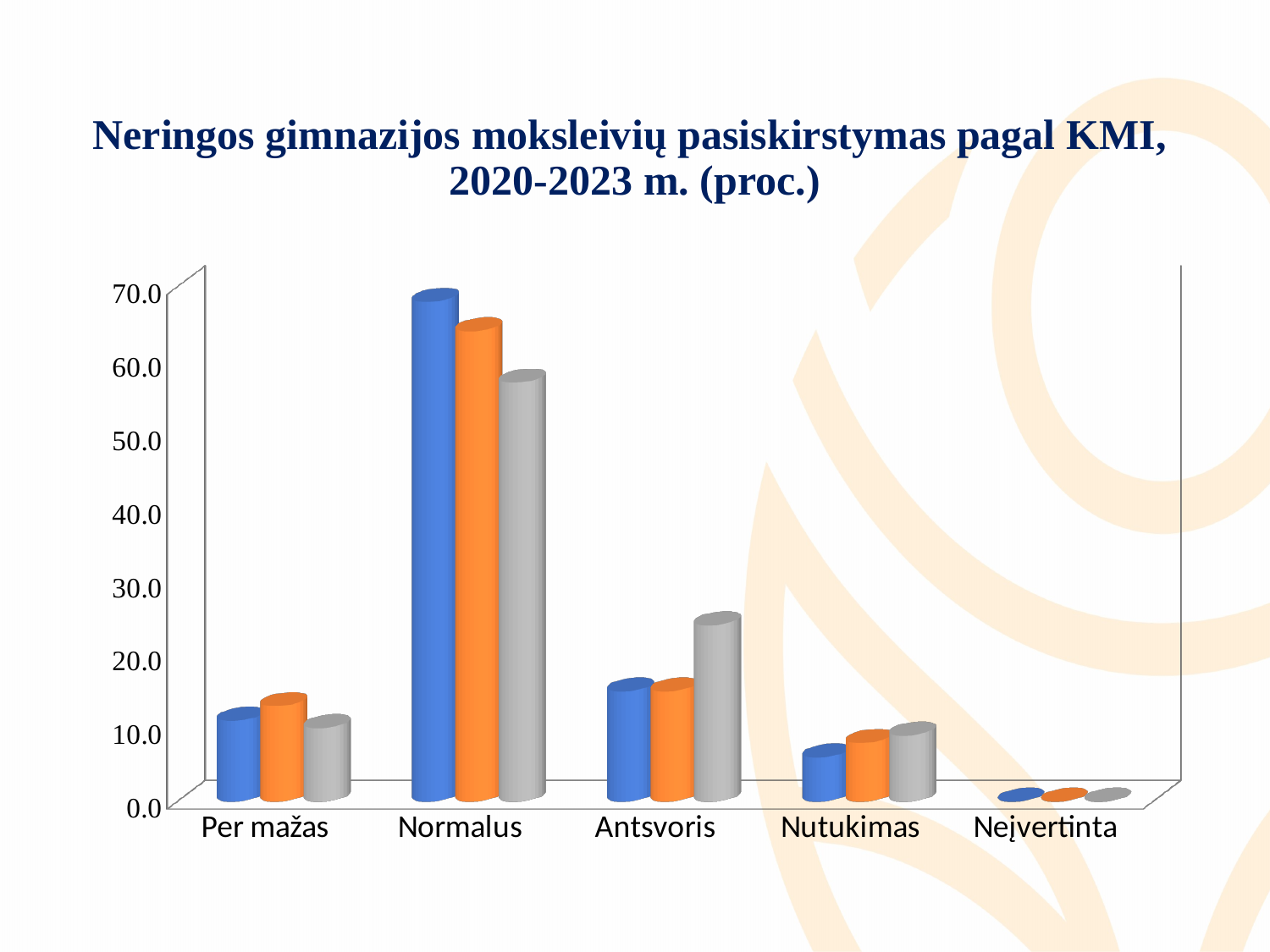
What kind of chart is shown on the slide? bar chart How many categories are shown on the x axis of the chart? 5 Is the value of the blue bar for Nutukimas greater or less than 10.0? less Which category has the highest bars in the chart? Normalus Which category has the lowest bars in the chart? Neįvertinta Which is larger: the blue bar for Normalus or the blue bar for Antsvoris? Normalus Is the value of the gray bar for Normalus greater or less than 50.0? greater Is the value of the orange bar for Per mažas greater or less than 20.0? less Within the Antsvoris category, which is larger: the gray bar or the blue bar? the gray bar What is the title of the chart on the slide? Neringos gimnazijos moksleivių pasiskirstymas pagal KMI, 2020-2023 m. (proc.)